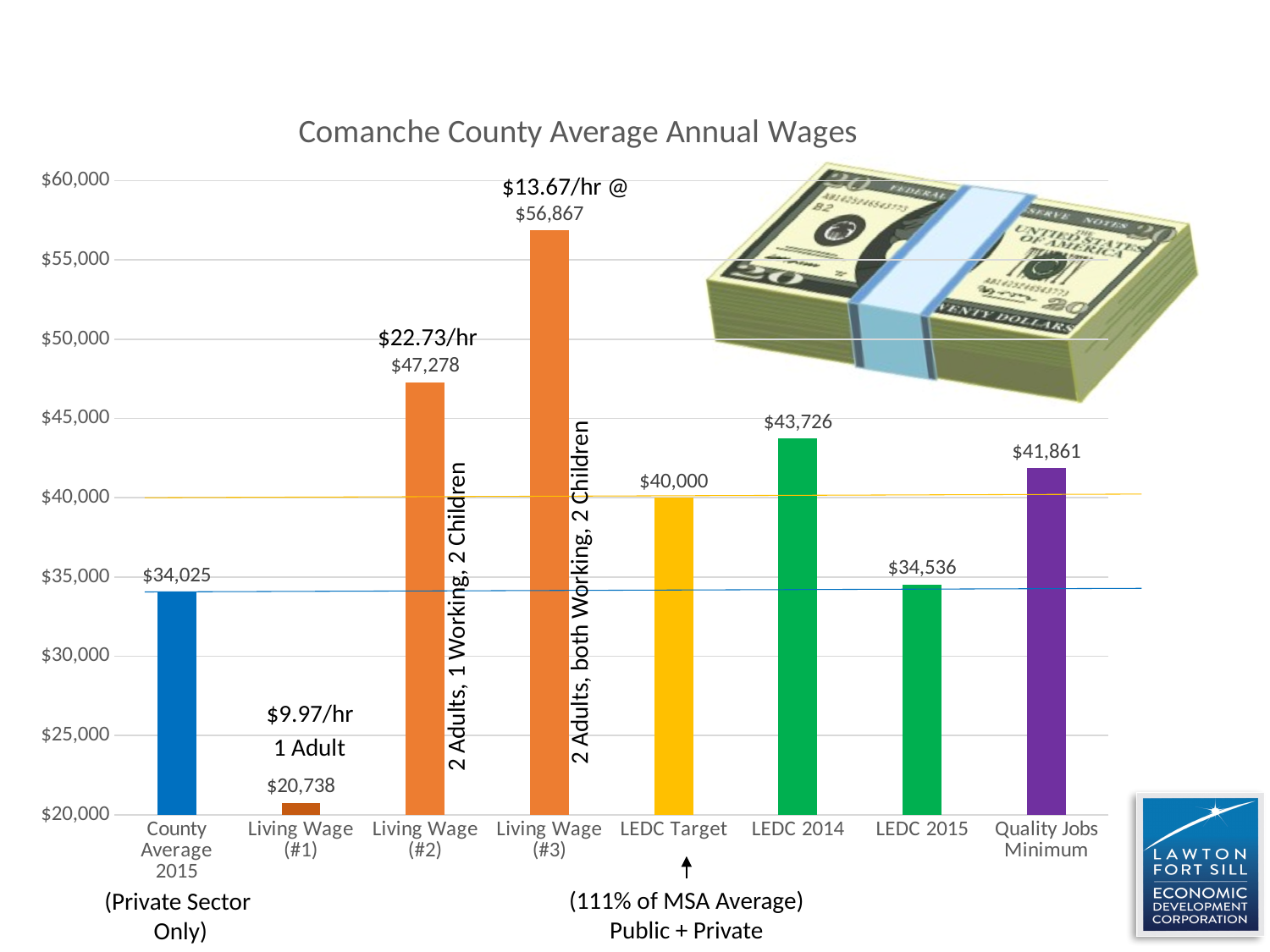
What hourly rate is shown above the Living Wage (#1) bar? $9.97/hr What is the value for Living Wage (#3)? $56,867 What is the difference between LEDC 2014 and LEDC 2015? $9,190 What is the value for Quality Jobs Minimum? $41,861 What type of chart is shown on the slide? bar chart What is the title of the chart? Comanche County Average Annual Wages Which category has the highest value? Living Wage (#3) What is the value for LEDC 2014? $43,726 What is the value for County Average 2015? $34,025 Which category has the lowest value? Living Wage (#1) Which is larger, Living Wage (#2) or LEDC Target? Living Wage (#2) How many categories are plotted on the x axis? 8